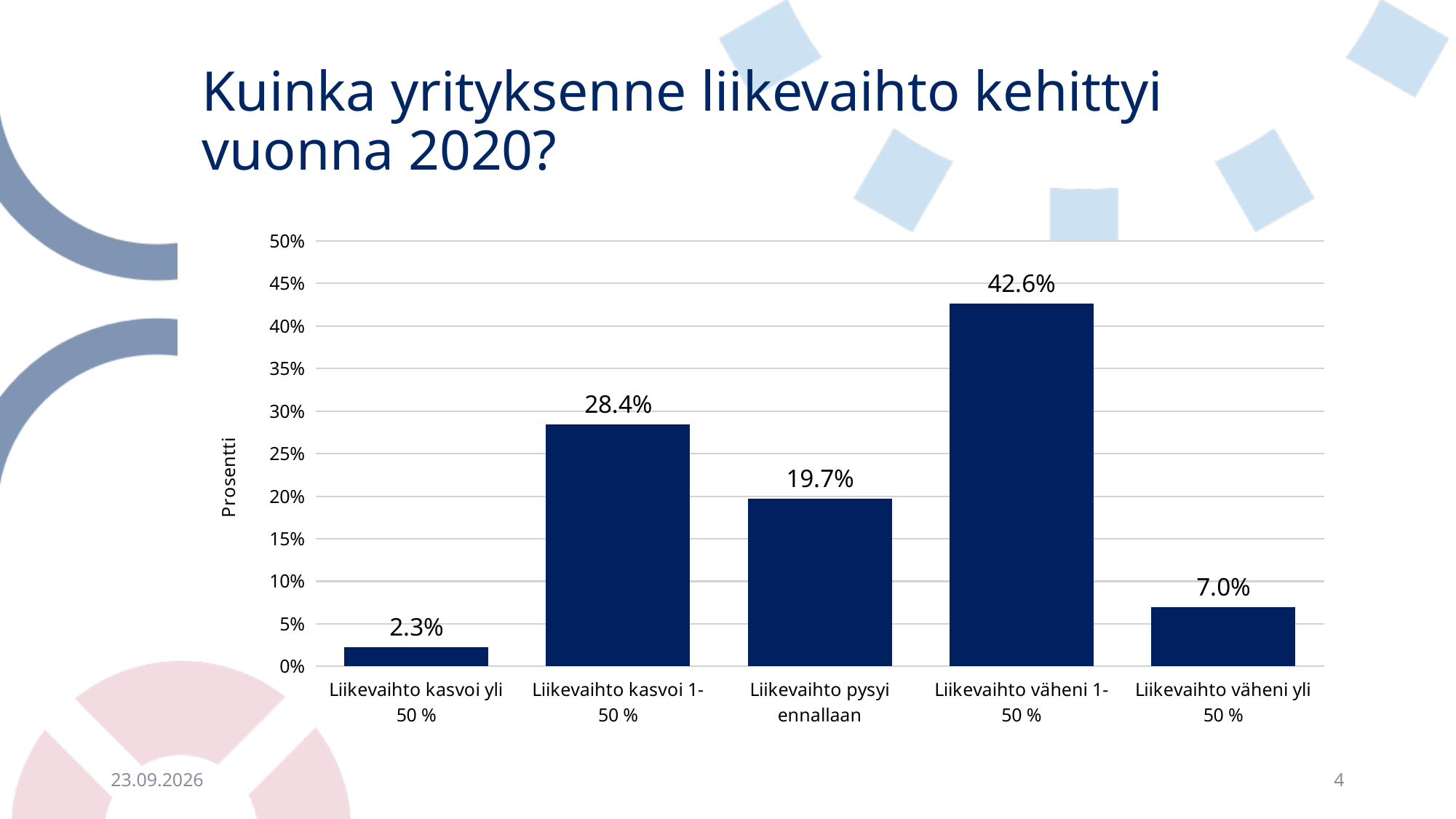
Is the value for "Liikevaihto kasvoi 1-50 %" greater or less than 25%? greater How many categories are shown on the x axis? 5 Which is larger, the value for "Liikevaihto pysyi ennallaan" or the value for "Liikevaihto väheni yli 50 %"? Liikevaihto pysyi ennallaan What kind of chart is shown on the slide? bar chart What is the value for "Liikevaihto kasvoi yli 50 %"? 2.3% Which category has the lowest value? Liikevaihto kasvoi yli 50 % What is the value for "Liikevaihto väheni yli 50 %"? 7.0% Which category has the highest value? Liikevaihto väheni 1-50 % What is the value for "Liikevaihto pysyi ennallaan"? 19.7% What is the difference between the values for "Liikevaihto väheni 1-50 %" and "Liikevaihto kasvoi 1-50 %"? 14.2% What is the label of the vertical axis? Prosentti What is the value for "Liikevaihto kasvoi 1-50 %"? 28.4%